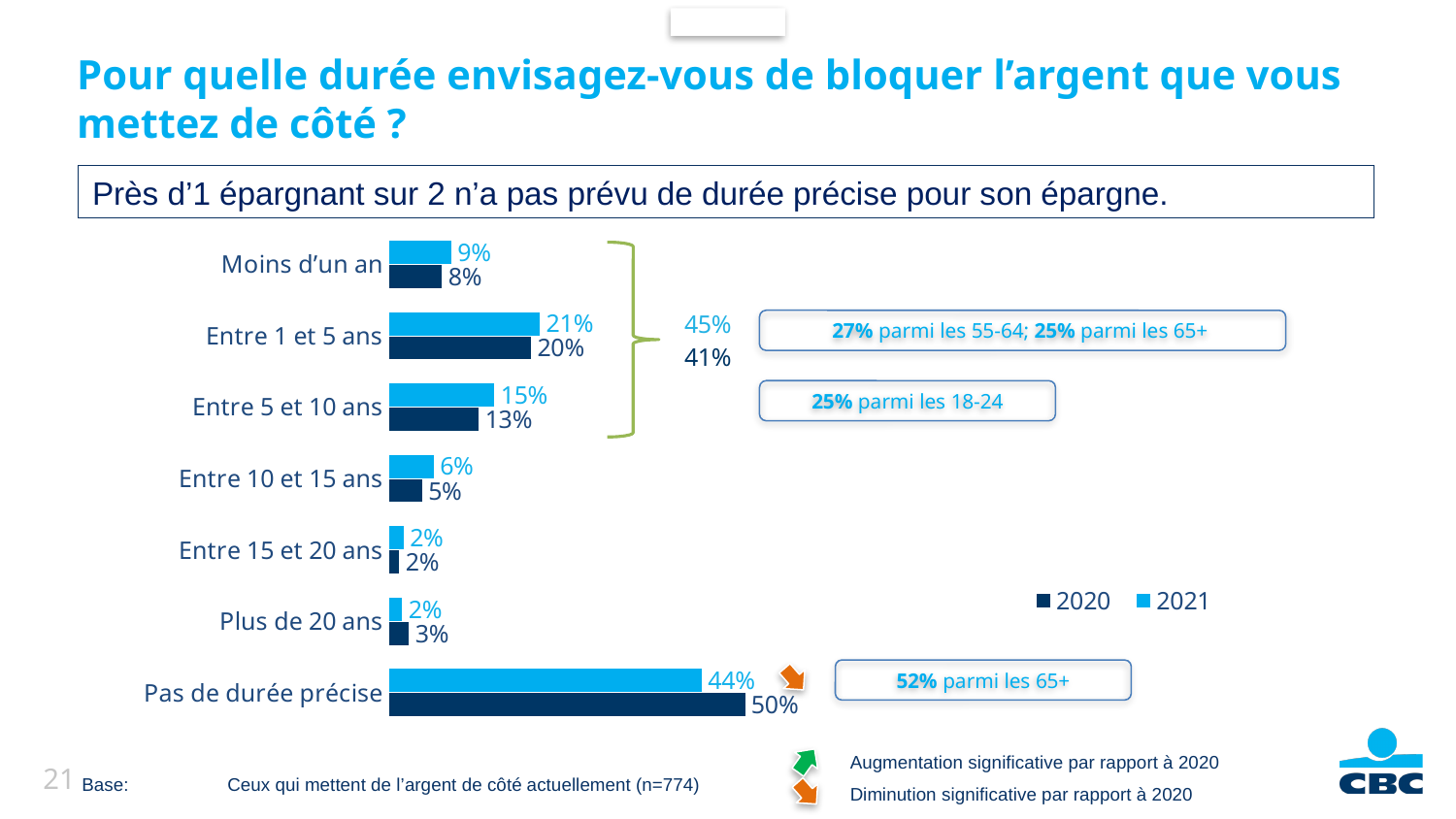
What is the 2021 value for "Pas de durée précise"? 44% How many categories are shown in the chart? 7 What is the 2020 value for "Plus de 20 ans"? 3% Which series is shown in dark blue according to the legend? 2020 Which is larger for "Moins d'un an": the 2020 value or the 2021 value? 2021 What kind of chart is shown on the slide? Bar chart What is the 2020 value for "Entre 1 et 5 ans"? 20% What is the 2021 value for "Entre 5 et 10 ans"? 15% How many series does the legend list? 2 Which category has the highest 2020 value? Pas de durée précise What is the difference between the 2020 and 2021 values for "Pas de durée précise"? 6 percentage points Which category has the highest 2021 value? Pas de durée précise